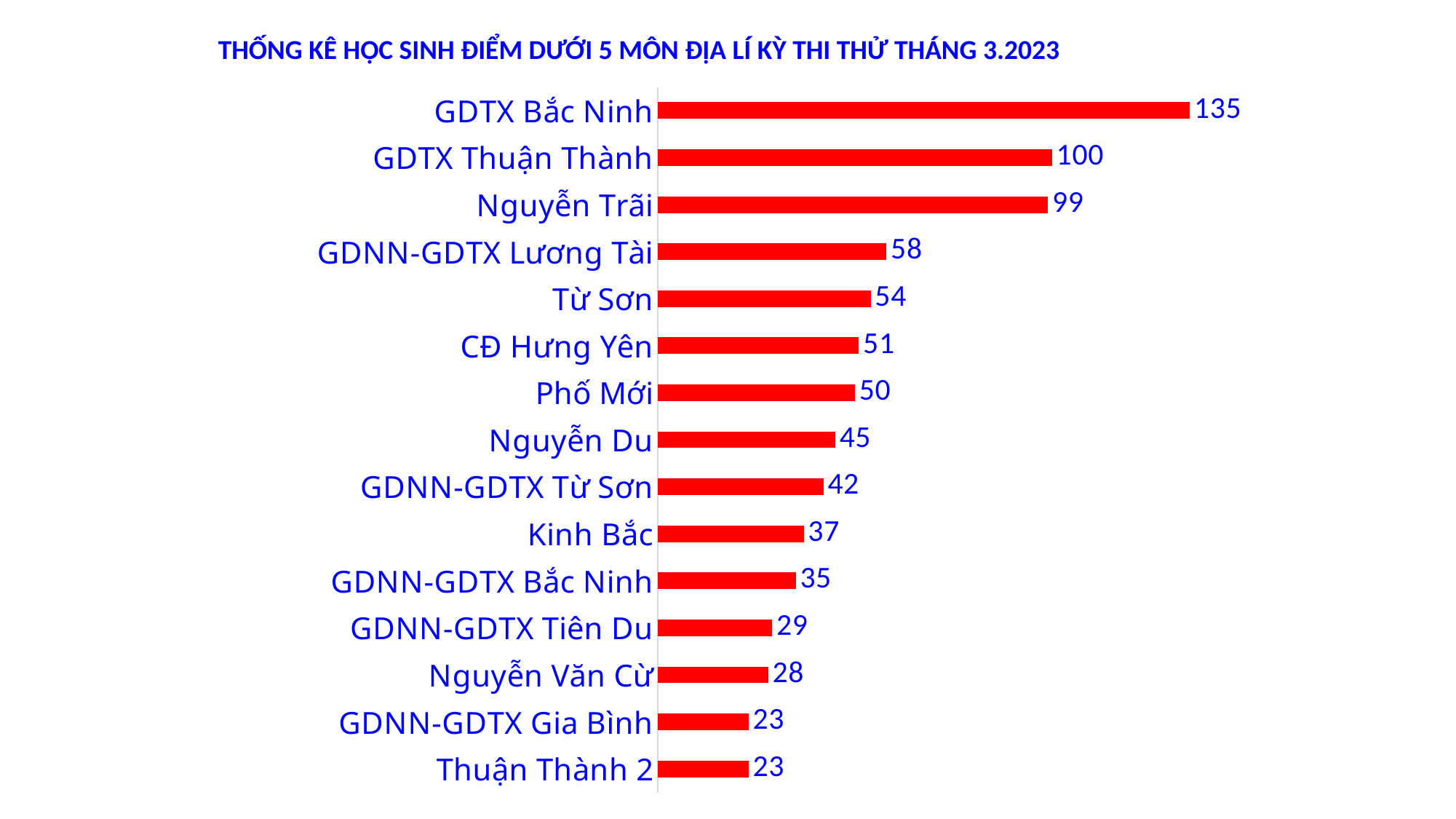
What is the value for GDNN-GDTX Từ Sơn? 42 Which is larger, the value for Nguyễn Du or the value for GDNN-GDTX Bắc Ninh? Nguyễn Du What is the value for Nguyễn Trãi? 99 Which is larger, the value for GDNN-GDTX Lương Tài or the value for Phố Mới? GDNN-GDTX Lương Tài What is the value for GDTX Bắc Ninh? 135 What kind of chart is shown on the slide? Bar chart What is the value for Nguyễn Văn Cừ? 28 Which category has the highest value? GDTX Bắc Ninh What is the difference between the values for GDTX Bắc Ninh and GDTX Thuận Thành? 35 What is the difference between the values for Từ Sơn and Kinh Bắc? 17 What colour are the bars in the chart? Red How many categories are shown in the chart? 15